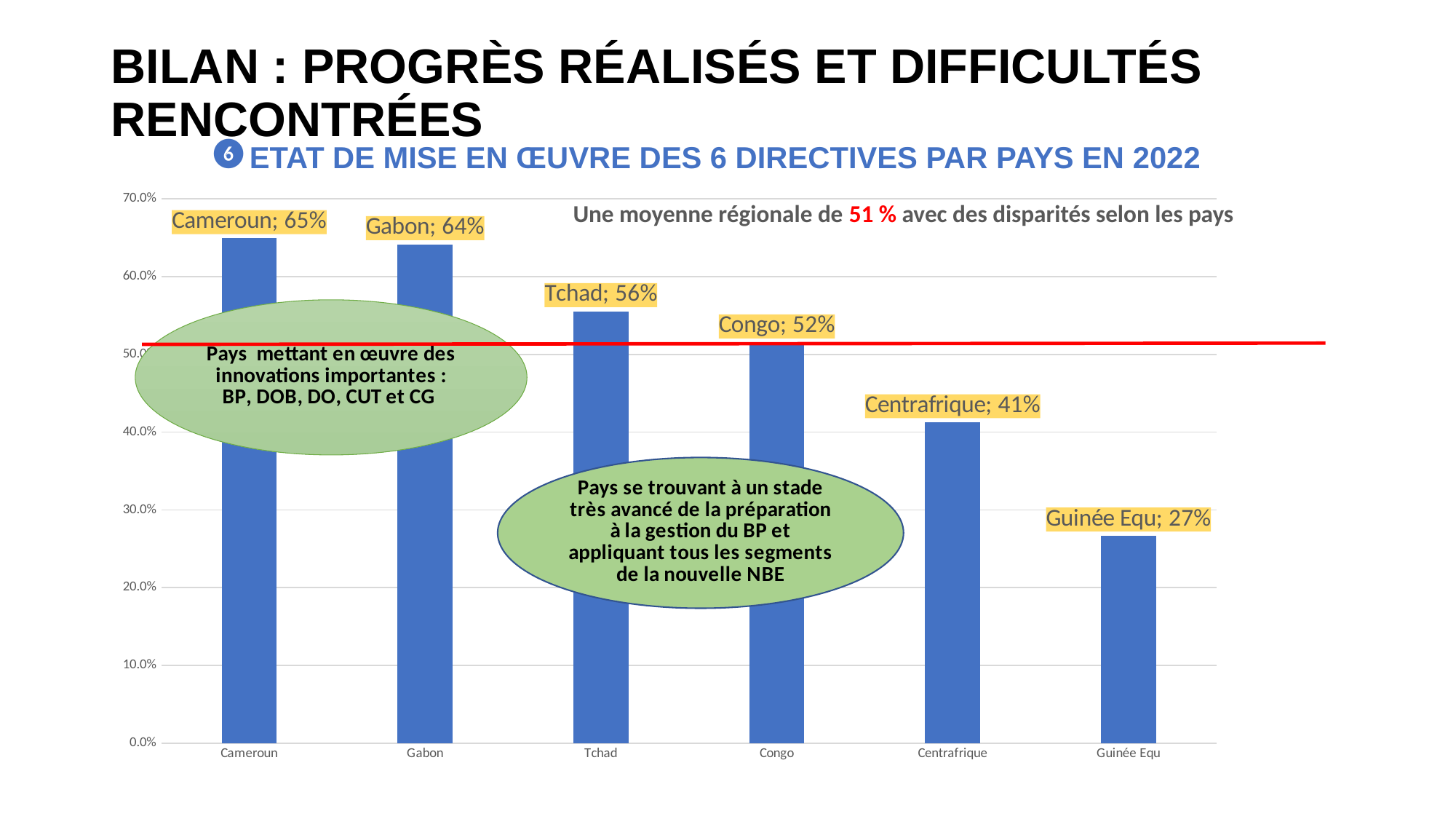
What regional average is stated on the chart? 51 % What is the value for Cameroun? 65% What is the value for Tchad? 56% Which country has the lowest value? Guinée Equ What is the difference between the values for Congo and Centrafrique? 11% How many countries are shown on the chart? 6 What kind of chart is shown on the slide? bar chart Is the value for Centrafrique greater or less than 50.0%? less Which country has the highest value? Cameroun Do the values rise or fall from left to right along the x axis? fall Which is larger, the value for Tchad or the value for Congo? Tchad What is the value for Guinée Equ? 27%